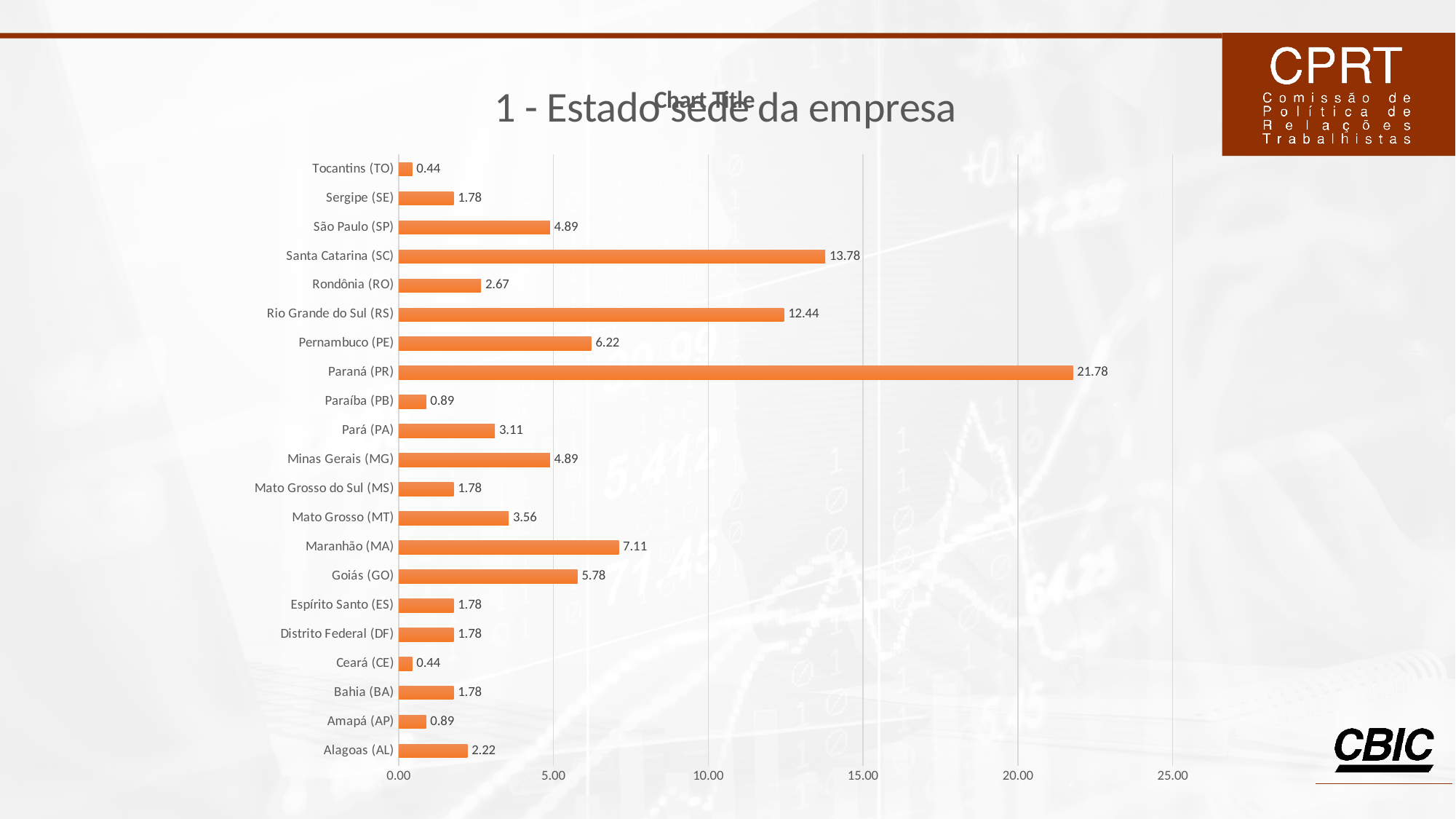
What is the difference between the values for Paraná (PR) and Santa Catarina (SC)? 8.00 What is the value for Maranhão (MA)? 7.11 Which is larger, the value for Pernambuco (PE) or the value for Goiás (GO)? Pernambuco (PE) What is the value for Alagoas (AL)? 2.22 How many states are shown in the chart? 21 What is the value for Santa Catarina (SC)? 13.78 Is the value for Rio Grande do Sul (RS) greater or less than 10.00? greater What is the value for Paraná (PR)? 21.78 What kind of chart is shown on the slide? Bar chart What is the difference between the values for Santa Catarina (SC) and Rio Grande do Sul (RS)? 1.34 What is the title of the slide above the chart? 1 - Estado sede da empresa Which state has the highest value? Paraná (PR)